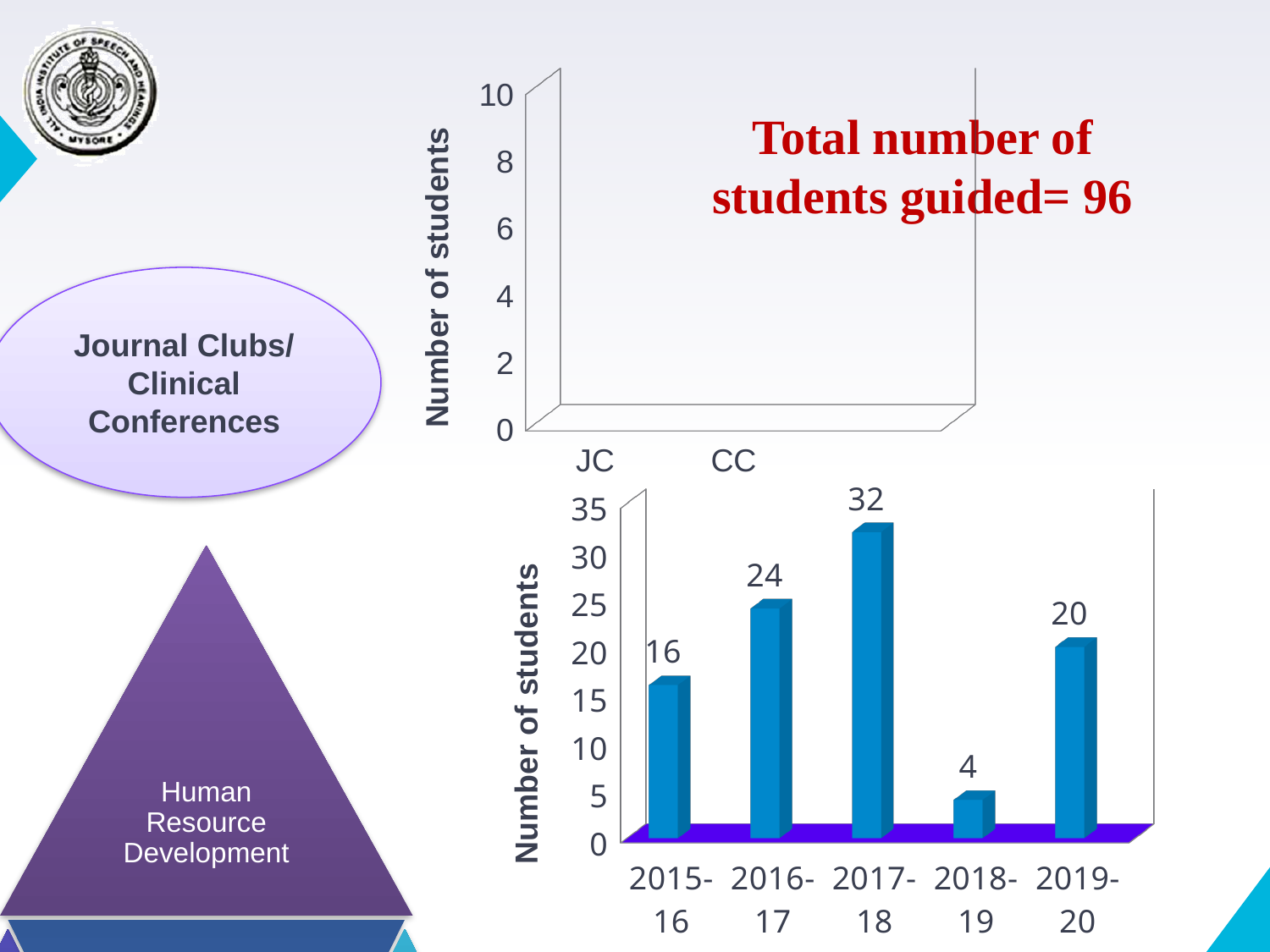
In the bottom chart, what is the difference in number of students between 2017-18 and 2018-19? 28 In the bottom chart, what is the difference in number of students between 2016-17 and 2015-16? 8 In the bottom chart, which year has the highest number of students? 2017-18 In the bottom chart, what is the number of students for 2019-20? 20 What is the y-axis label of the bottom chart? Number of students In the bottom chart, which year has more students, 2016-17 or 2019-20? 2016-17 In the bottom chart, what is the number of students for 2018-19? 4 How many years are shown on the x axis of the bottom chart? 5 In the bottom chart, what is the number of students for 2017-18? 32 In the bottom chart, what is the number of students for 2015-16? 16 In the bottom chart, which year has the lowest number of students? 2018-19 What kind of chart is the bottom chart? bar chart